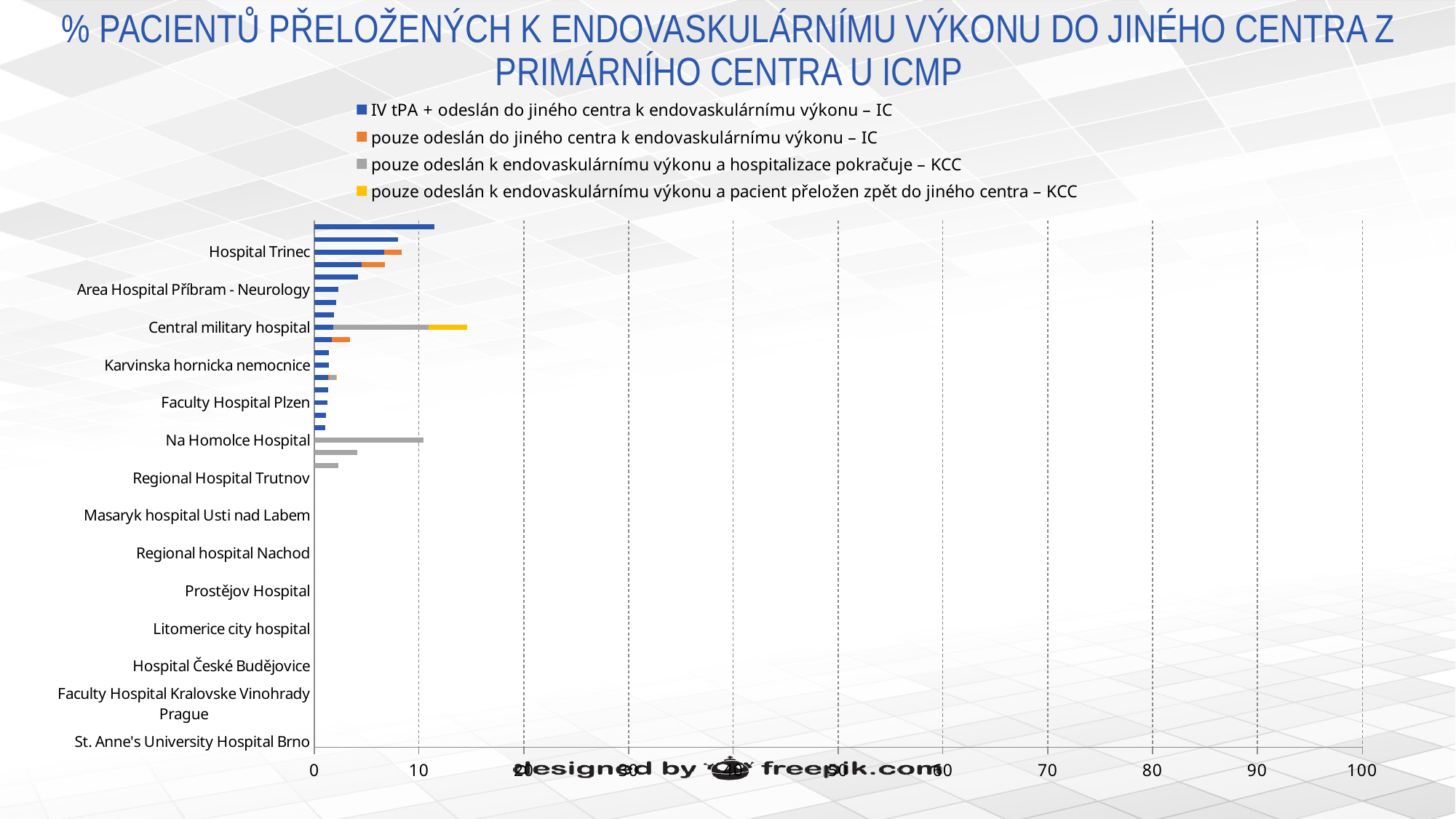
Is the longest bar on the chart greater or less than 50? less Is the longest bar on the chart greater or less than 20? less What is the title of the chart? % PACIENTŮ PŘELOŽENÝCH K ENDOVASKULÁRNÍMU VÝKONU DO JINÉHO CENTRA Z PRIMÁRNÍHO CENTRA U ICMP Which category label appears at the top of the chart? Hospital Trinec How many series does the legend list? 4 What is the highest value shown on the horizontal axis? 100 What kind of chart is shown on the slide? bar chart